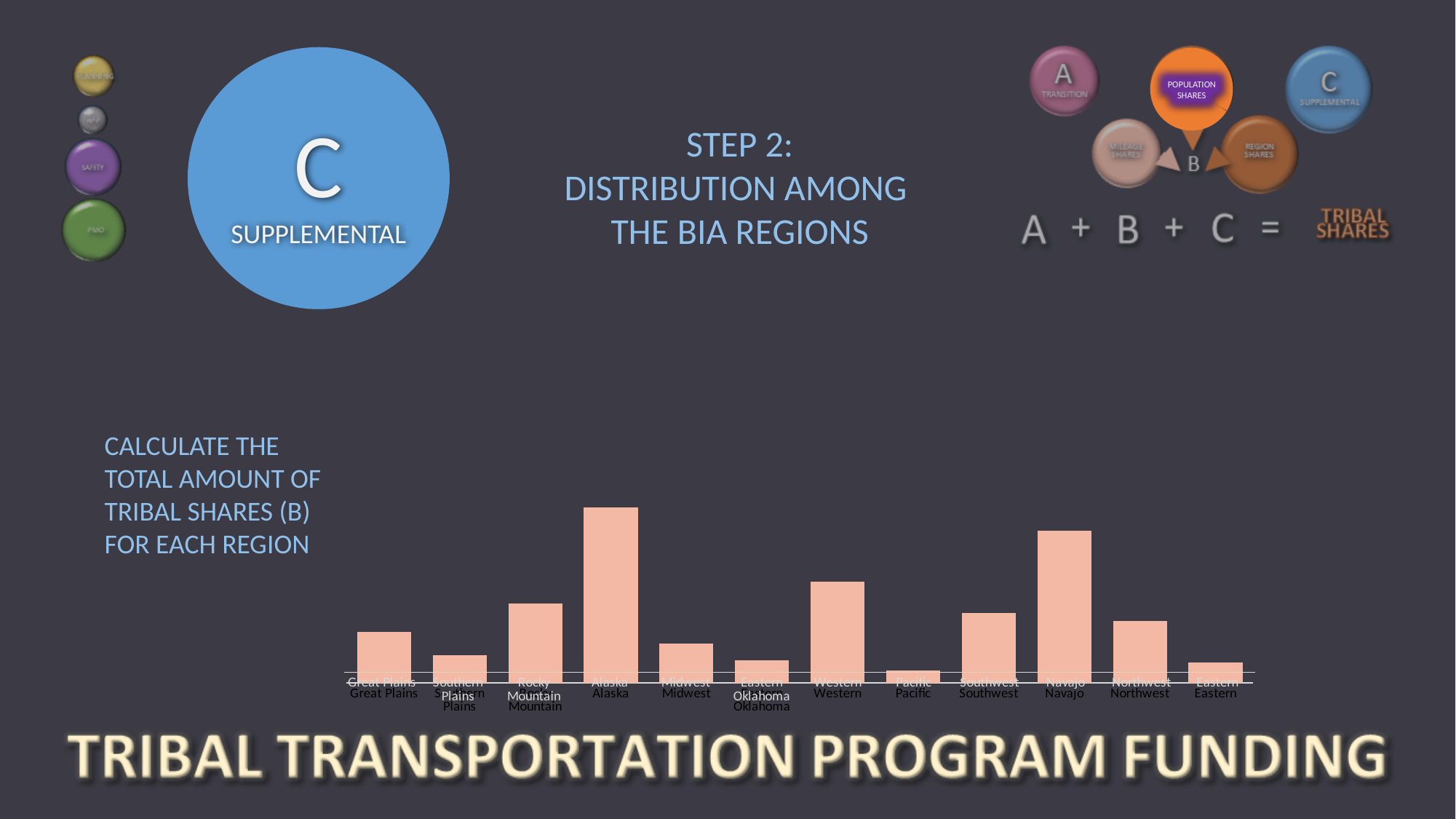
Which region has the second tallest bar in the chart? Navajo Which region has the tallest bar in the chart? Alaska Which bar is taller, Navajo or Western? Navajo Which region has the shortest bar in the chart? Pacific Which bar is taller, Eastern or Pacific? Eastern Which bar is taller, Great Plains or Southern Plains? Great Plains What kind of chart is shown on the slide? Bar chart How many regions are shown on the x axis of the bar chart? 12 What is the first region listed on the x axis of the chart? Great Plains